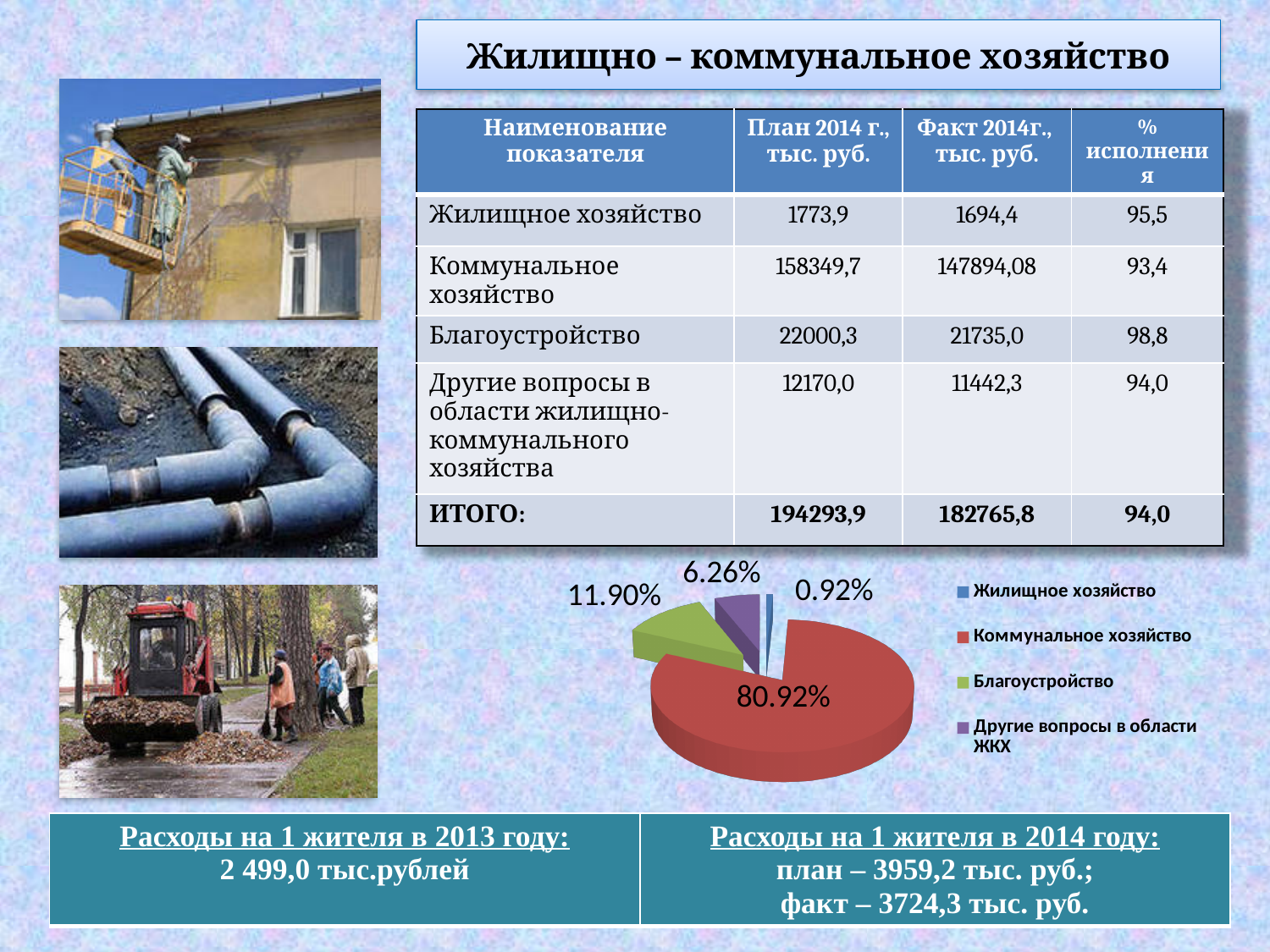
How many slices does the pie chart have? 4 What colour is the Коммунальное хозяйство slice in the pie chart? red How many entries does the legend of the pie chart list? 4 What share of the pie does Коммунальное хозяйство have? 80.92% Which category has the smallest slice of the pie? Жилищное хозяйство Which category has the largest slice of the pie? Коммунальное хозяйство What share of the pie does Другие вопросы в области ЖКХ have? 6.26% What kind of chart is shown on the slide? pie chart What share of the pie does Благоустройство have? 11.90% What is the difference between the shares of Коммунальное хозяйство and Благоустройство? 69.02% Which slice is larger: Благоустройство or Другие вопросы в области ЖКХ? Благоустройство